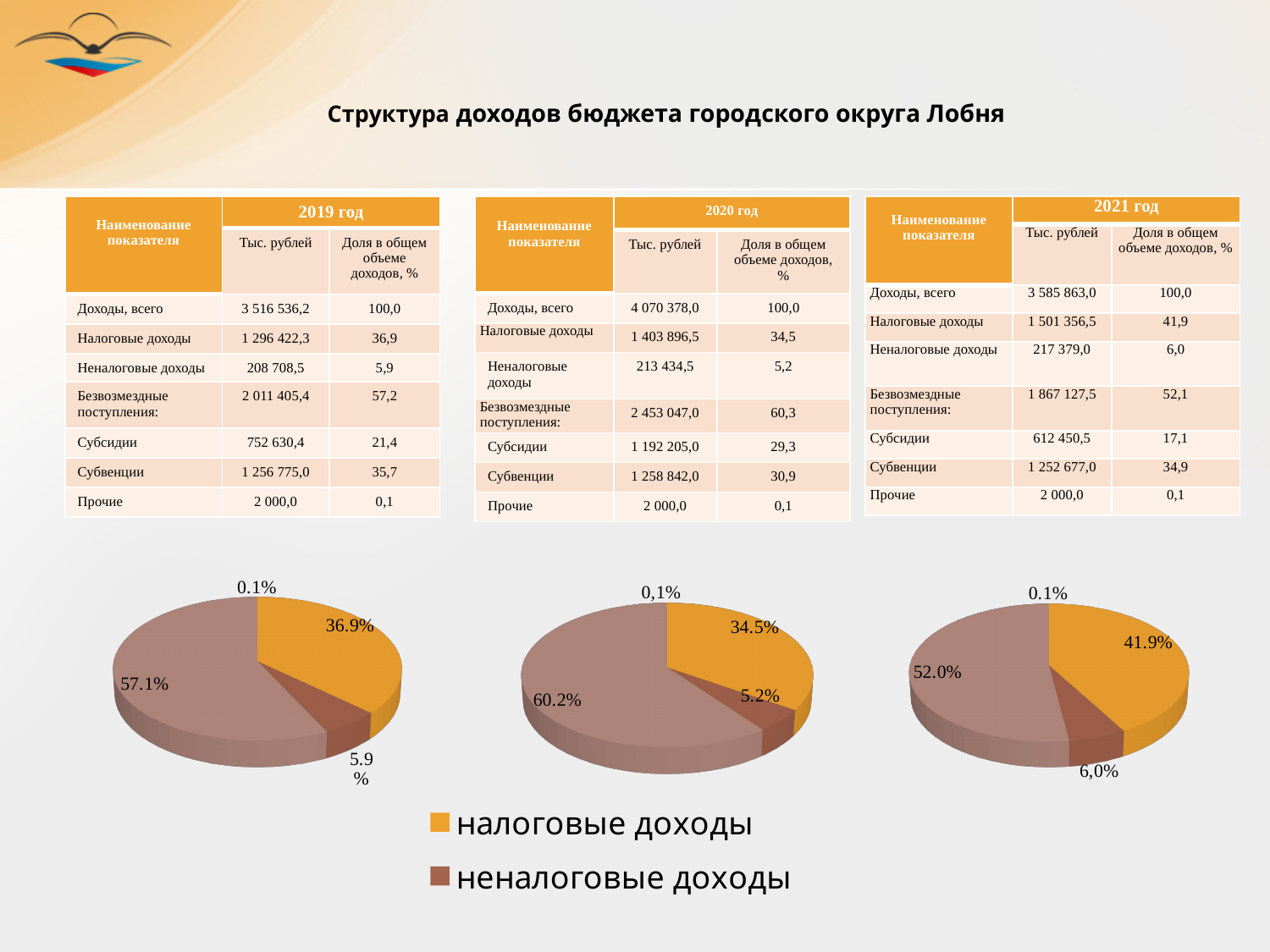
In the middle pie chart, what share is shown for неналоговые доходы? 5.2% In the left pie chart, which is larger: налоговые доходы or неналоговые доходы? налоговые доходы What colour represents налоговые доходы in the legend? orange In the left pie chart, what share is shown for налоговые доходы? 36.9% How many pie charts are on the slide? 3 What kind of chart is used on this slide? pie chart In the right pie chart, what share is shown for неналоговые доходы? 6,0% What is the smallest slice value labelled in the middle pie chart? 0,1% In the right pie chart, what share is shown for налоговые доходы? 41.9% What is the largest slice value labelled in the right pie chart? 52.0% How many slices does the left pie chart have? 4 In the middle pie chart, what is the difference between the shares of налоговые доходы and неналоговые доходы? 29.3%